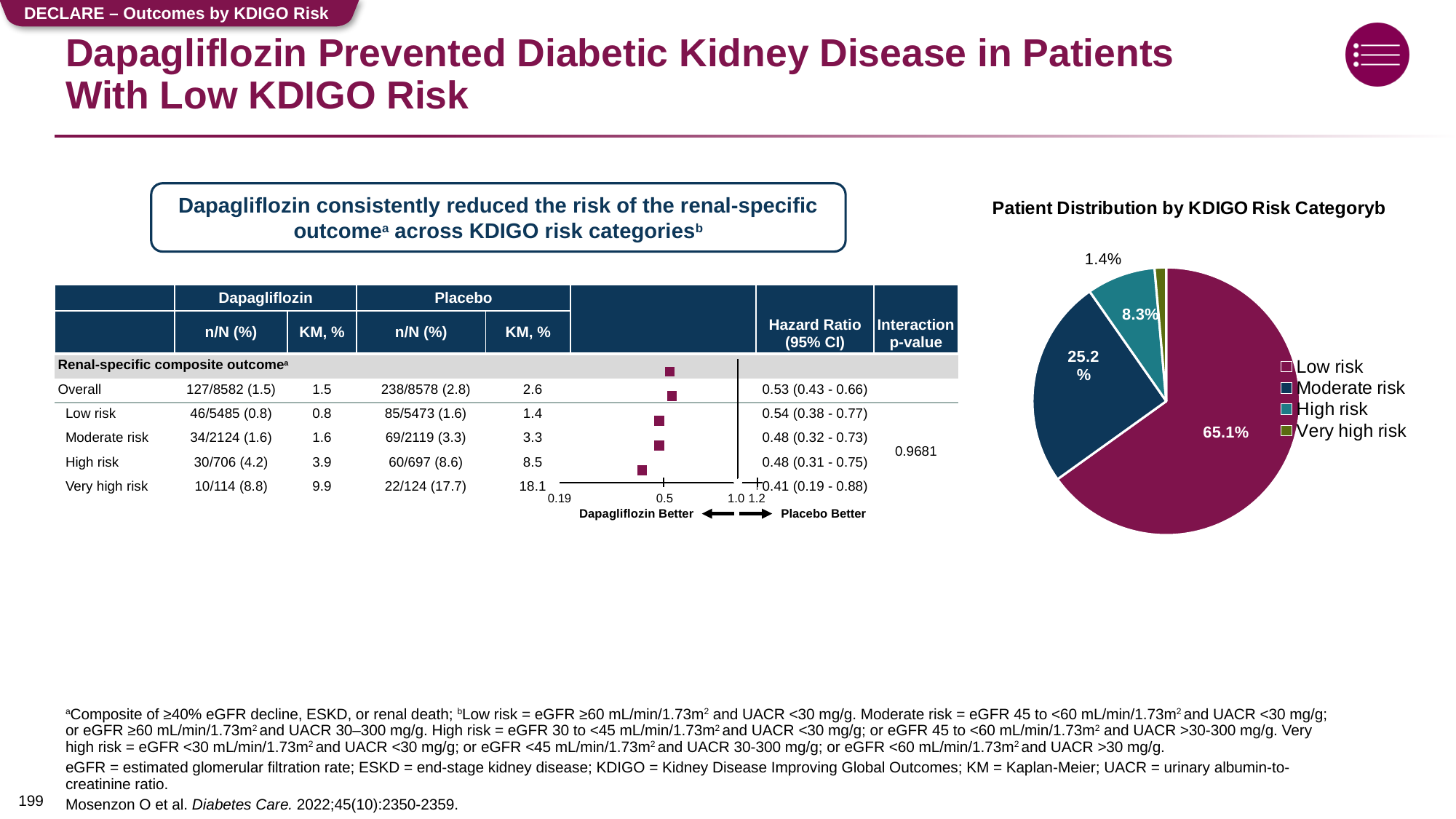
How many risk categories are shown in the pie chart 'Patient Distribution by KDIGO Risk Category'? 4 In the forest plot on the left of the slide, which KDIGO risk group has the lowest hazard ratio point estimate? Very high risk In the pie chart 'Patient Distribution by KDIGO Risk Category', what percentage of patients are in the Moderate risk category? 25.2% What type of chart is used to show the patient distribution by KDIGO risk category? Pie chart In the pie chart 'Patient Distribution by KDIGO Risk Category', how many percentage points larger is the Low risk share than the Moderate risk share? 39.9 percentage points In the pie chart 'Patient Distribution by KDIGO Risk Category', which risk category has the smallest share of patients? Very high risk In the pie chart 'Patient Distribution by KDIGO Risk Category', what percentage of patients are in the High risk category? 8.3% In the forest plot on the left of the slide, what is the hazard ratio (95% CI) for the Very high risk group? 0.41 (0.19 - 0.88) In the pie chart 'Patient Distribution by KDIGO Risk Category', what percentage of patients are in the Very high risk category? 1.4% In the pie chart 'Patient Distribution by KDIGO Risk Category', which is larger: the Moderate risk share or the High risk share? Moderate risk In the pie chart 'Patient Distribution by KDIGO Risk Category', which risk category has the largest share of patients? Low risk In the pie chart 'Patient Distribution by KDIGO Risk Category', what percentage of patients are in the Low risk category? 65.1%